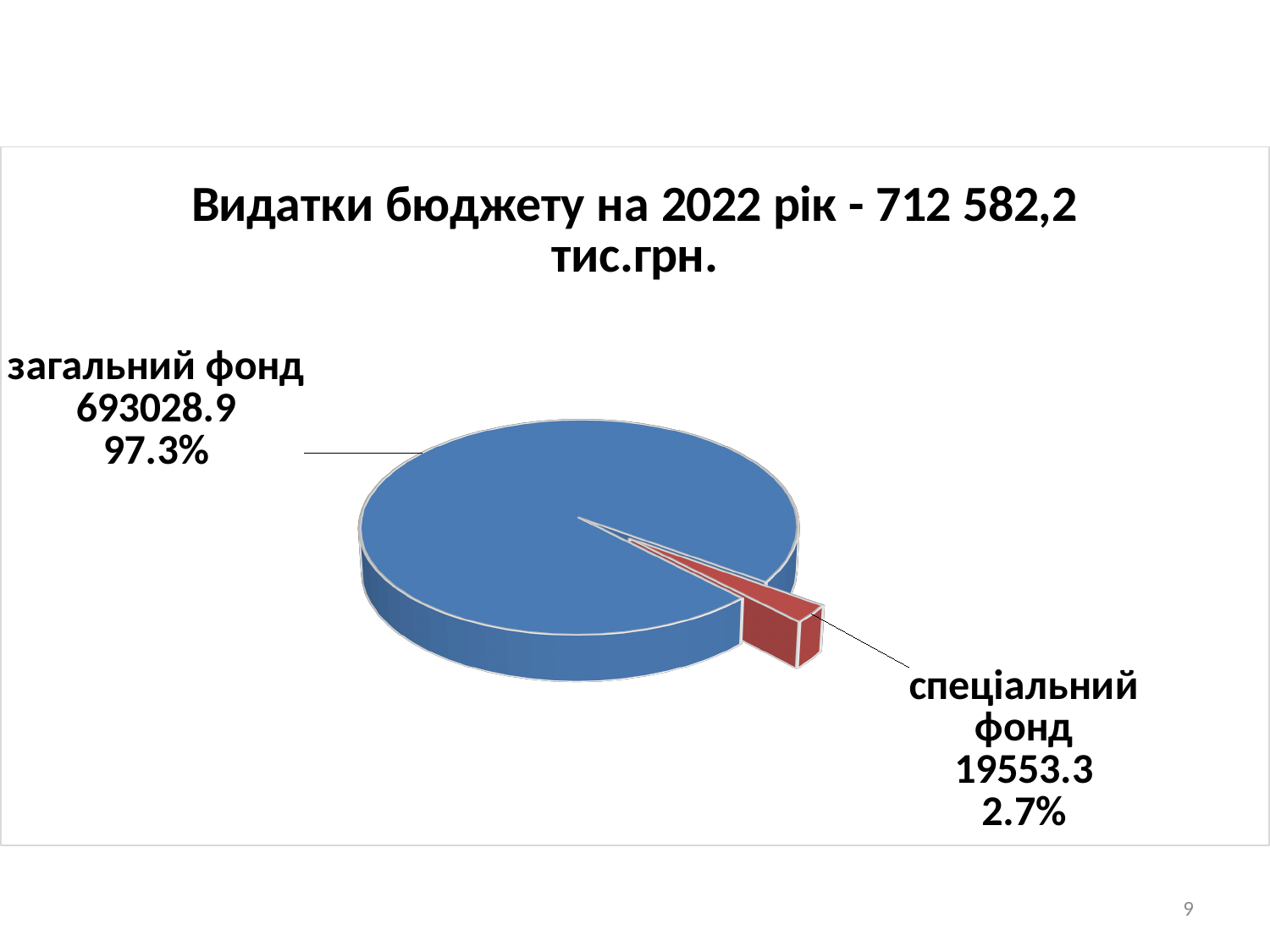
What share of the pie does загальний фонд represent? 97.3% What is the value for загальний фонд? 693028.9 What kind of chart is shown on the slide? pie chart Which is larger, загальний фонд or спеціальний фонд? загальний фонд Which category has the smallest slice? спеціальний фонд Which category has the largest slice? загальний фонд What is the difference between the values for загальний фонд and спеціальний фонд? 673475.6 What is the title of the chart? Видатки бюджету на 2022 рік - 712 582,2 тис.грн. How many slices does the pie chart have? 2 What is the value for спеціальний фонд? 19553.3 What colour is the slice for спеціальний фонд? red What share of the pie does спеціальний фонд represent? 2.7%